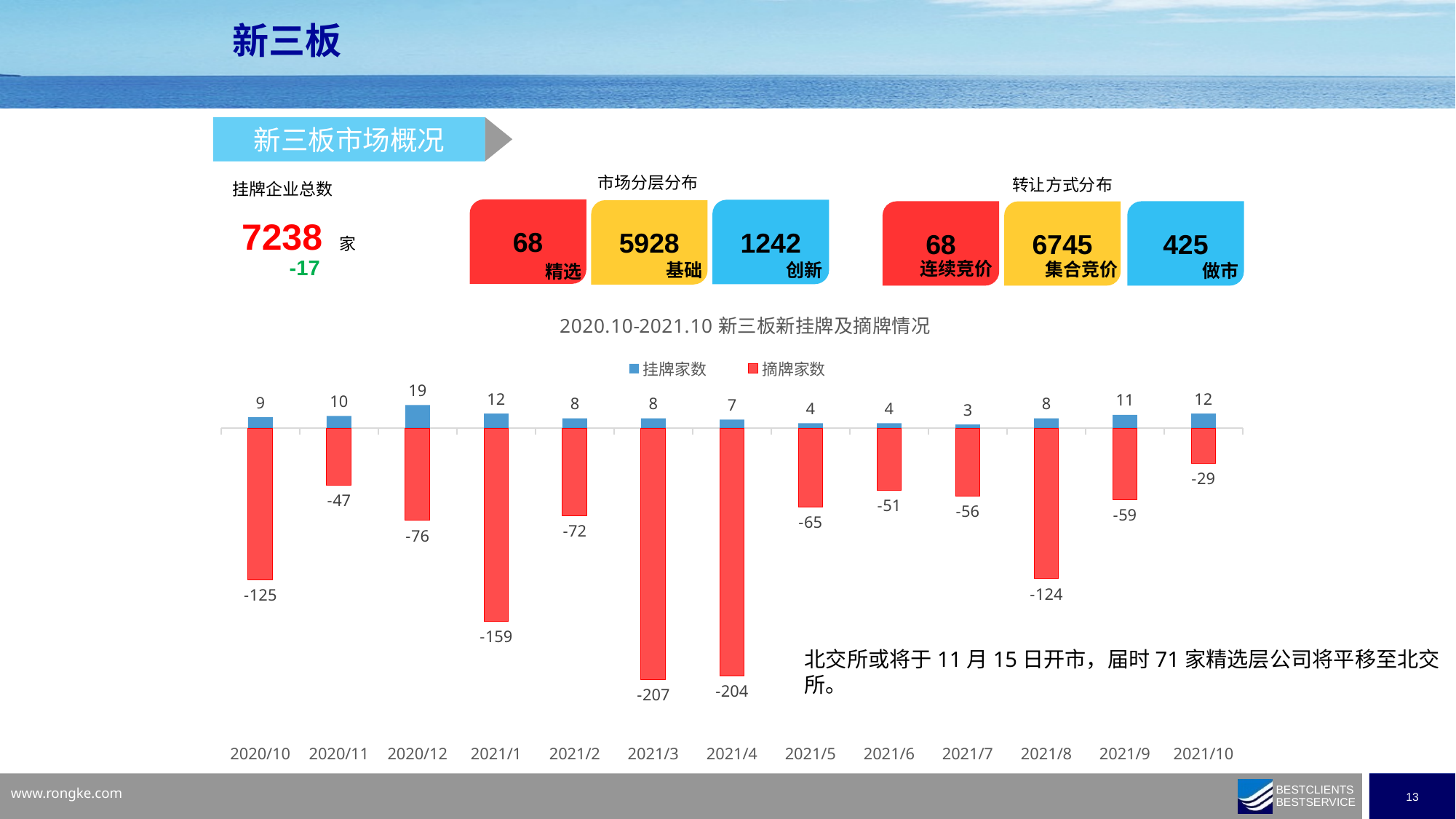
Which is larger in absolute terms, the 摘牌家数 for 2020/10 or for 2021/8? 2020/10 What is the 摘牌家数 value for 2021/3? -207 What is the difference between the 挂牌家数 values for 2020/12 and 2021/7? 16 What is the title of the chart? 2020.10-2021.10 新三板新挂牌及摘牌情况 How many months are shown on the x axis of the chart? 13 What is the 摘牌家数 value for 2021/10? -29 What type of chart is shown on the slide? bar chart Which month has the highest 挂牌家数 value? 2020/12 Which month has the lowest 挂牌家数 value? 2021/7 How many series does the chart legend list? 2 What is the 挂牌家数 value for 2020/12? 19 Which month has the largest number of 摘牌家数 (the most negative value)? 2021/3